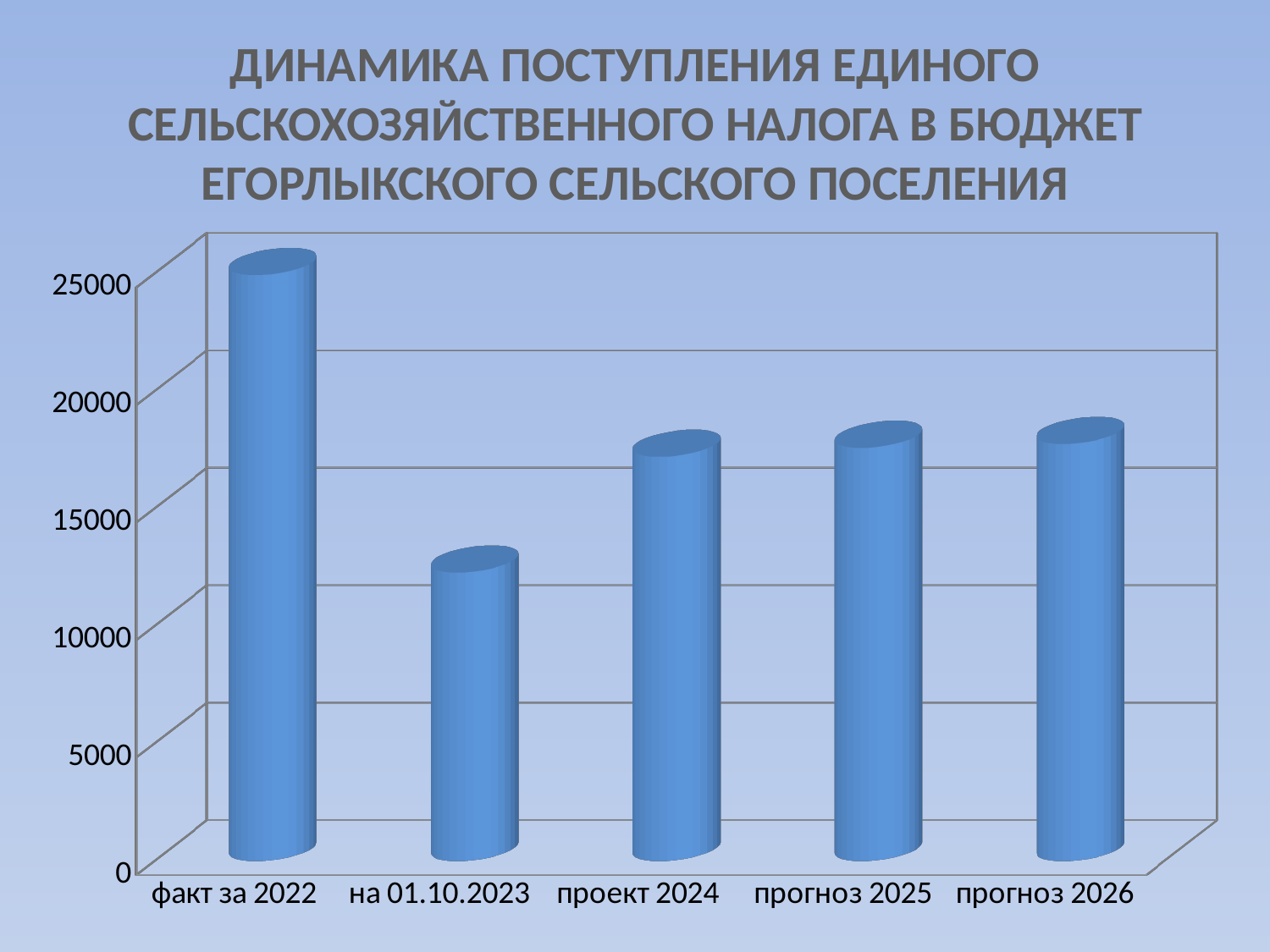
Which category has the lowest value in the chart? на 01.10.2023 Which is larger, the value for на 01.10.2023 or the value for прогноз 2025? прогноз 2025 What is the highest value shown on the vertical axis of the chart? 25000 What is the label of the last category on the x axis? прогноз 2026 Is the value for проект 2024 greater or less than 15000? greater What kind of chart is shown on the slide? bar chart How many categories are shown on the x axis of the chart? 5 Which category has the highest value in the chart? факт за 2022 Is the value for на 01.10.2023 greater or less than 15000? less Is the value for факт за 2022 greater or less than 20000? greater Which is larger, the value for факт за 2022 or the value for проект 2024? факт за 2022